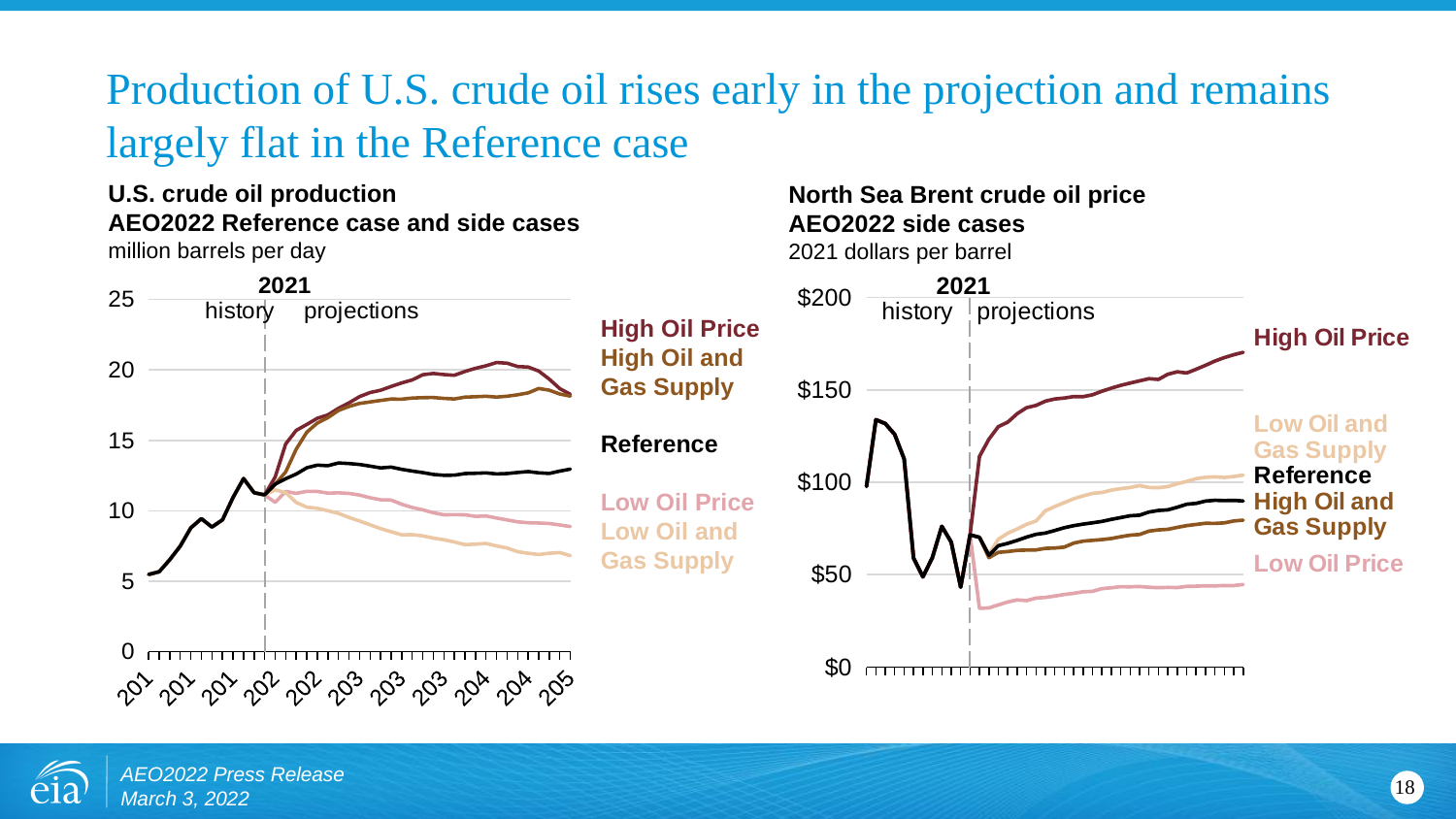
What kind of chart is the U.S. crude oil production chart on the left? line chart On the U.S. crude oil production chart, which is higher at the end of the projection: the High Oil Price case or the Reference case? High Oil Price On the U.S. crude oil production chart, which case has the lowest production at the end of the projection? Low Oil and Gas Supply How many series (cases) are labelled on the North Sea Brent crude oil price chart on the right? 5 On the North Sea Brent crude oil price chart, is the Low Oil Price value at the end of the projection greater or less than $50? less On the U.S. crude oil production chart, is the High Oil Price value at the end of the projection greater or less than 15? greater On the U.S. crude oil production chart, what unit is the y axis measured in? million barrels per day On the North Sea Brent crude oil price chart, which case has the highest price at the end of the projection? High Oil Price On the U.S. crude oil production chart, is the Low Oil and Gas Supply value at the end of the projection greater or less than 10? less On the North Sea Brent crude oil price chart, what year does the dashed line separating history from projections mark? 2021 On the North Sea Brent crude oil price chart, does the High Oil Price series rise or fall over the projection period? rise